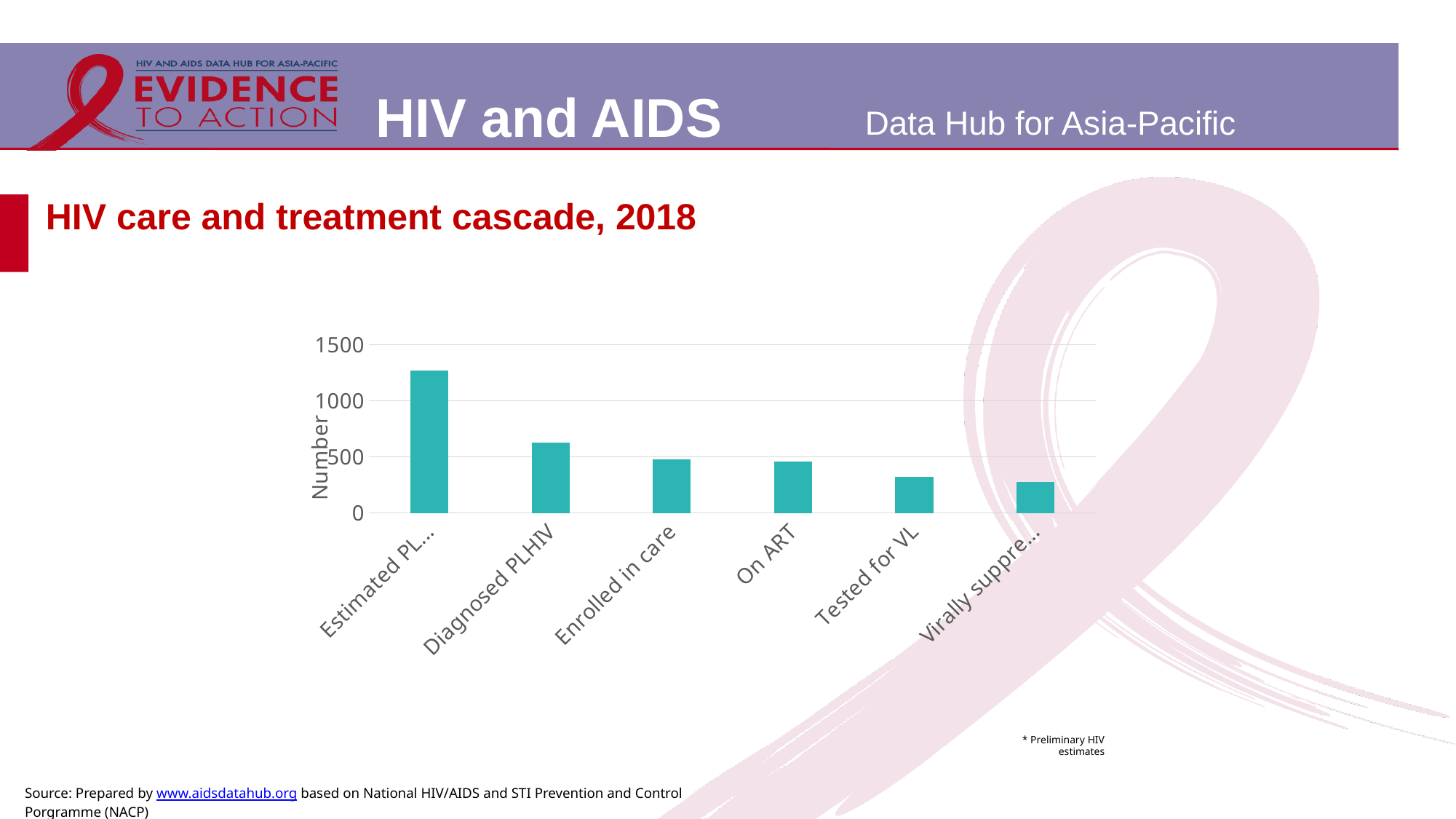
What is the title of the chart on the slide? HIV care and treatment cascade, 2018 Is the value for Diagnosed PLHIV greater or less than 500? greater What kind of chart is shown on the slide? bar chart How many categories (bars) are plotted in the chart? 6 Is the value for Tested for VL greater or less than 500? less Which is larger, the value for Diagnosed PLHIV or the value for Tested for VL? Diagnosed PLHIV What is the label on the vertical axis of the chart? Number Is the value for Enrolled in care greater or less than 1000? less Do the bar values rise or fall moving from left to right along the x axis? fall Which is larger, the value for Diagnosed PLHIV or the value for On ART? Diagnosed PLHIV